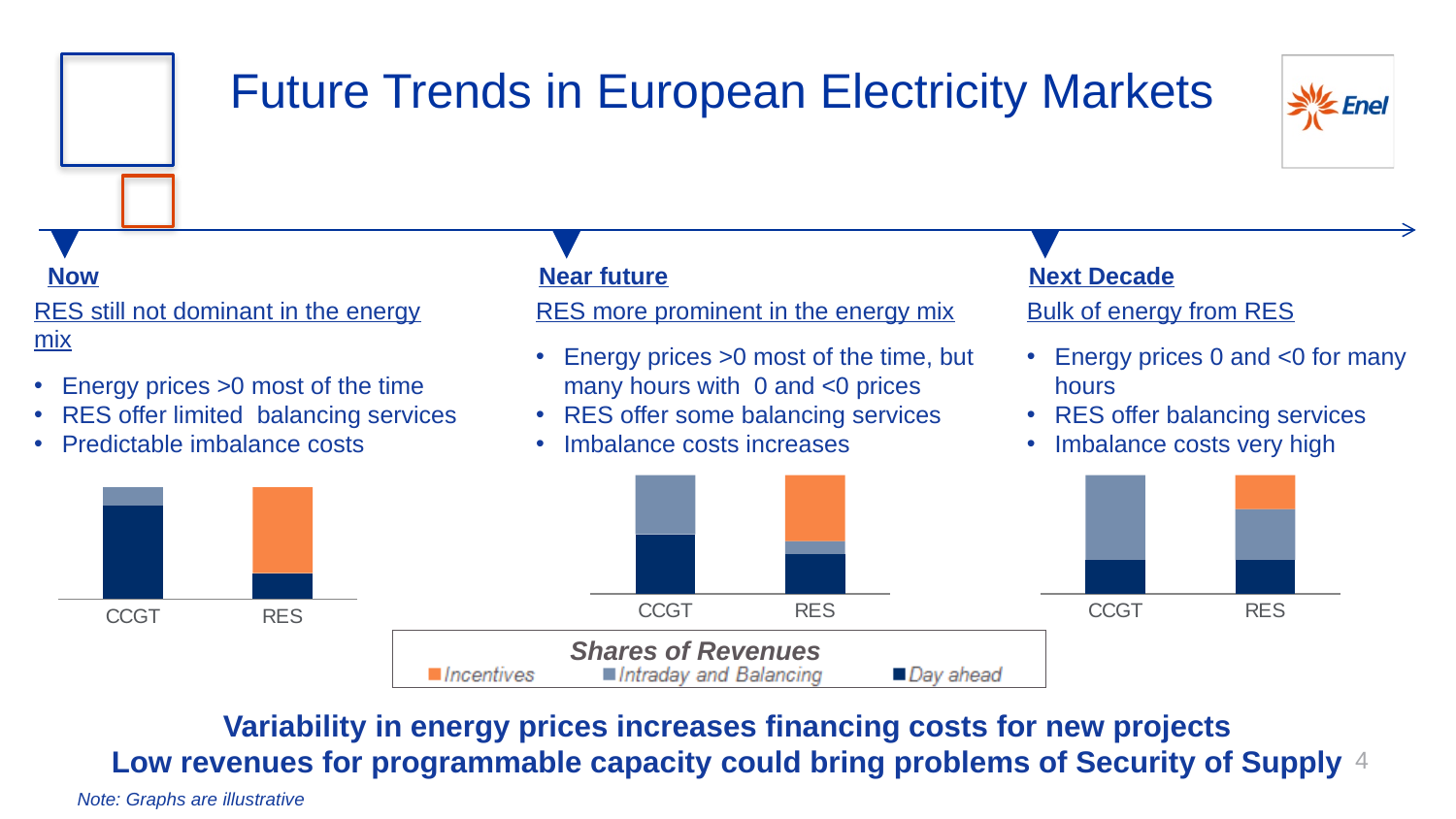
In the "Now" chart, which is larger for CCGT: the Day ahead segment or the Intraday and Balancing segment? Day ahead How many categories does the "Near future" chart show on its x axis? 2 In the "Near future" chart, which is larger for RES: the Incentives segment or the Day ahead segment? Incentives How many bar charts are shown on the slide? 3 In the "Next Decade" chart, which is larger for CCGT: the Intraday and Balancing segment or the Day ahead segment? Intraday and Balancing How many series does the shared legend list for the charts? 3 Across the three charts, which series appears only in the RES bars and never in the CCGT bars? Incentives What are the two categories shown in the "Next Decade" chart? CCGT and RES What title is given to the shared legend of the charts? Shares of Revenues What kind of chart is shown under the "Now" heading? Stacked bar chart